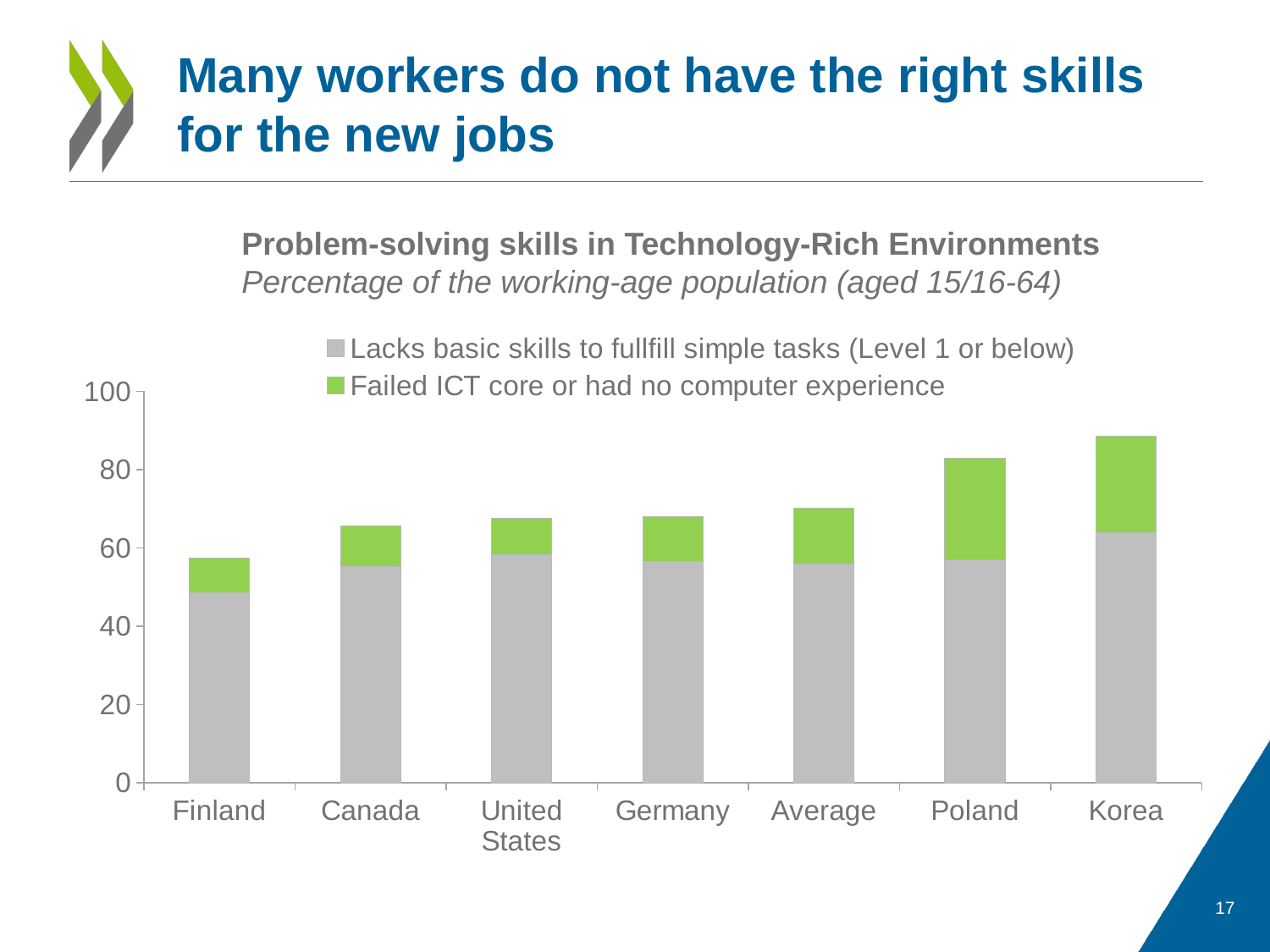
How many countries/categories are shown on the x axis of the chart? 7 Is the total stacked value for Korea greater or less than 80? greater How many series does the chart's legend list? 2 Which colour represents 'Failed ICT core or had no computer experience' in the chart? Green Is the total stacked value for Poland greater or less than 80? greater Do the total bar heights generally rise or fall moving from Finland on the left to Korea on the right? rise Which category has the tallest stacked bar overall? Korea Which category has the shortest stacked bar overall? Finland Is the total stacked value for Finland greater or less than 60? less Which has a larger total stacked bar, Poland or Canada? Poland What kind of chart is shown on the slide? Stacked bar chart